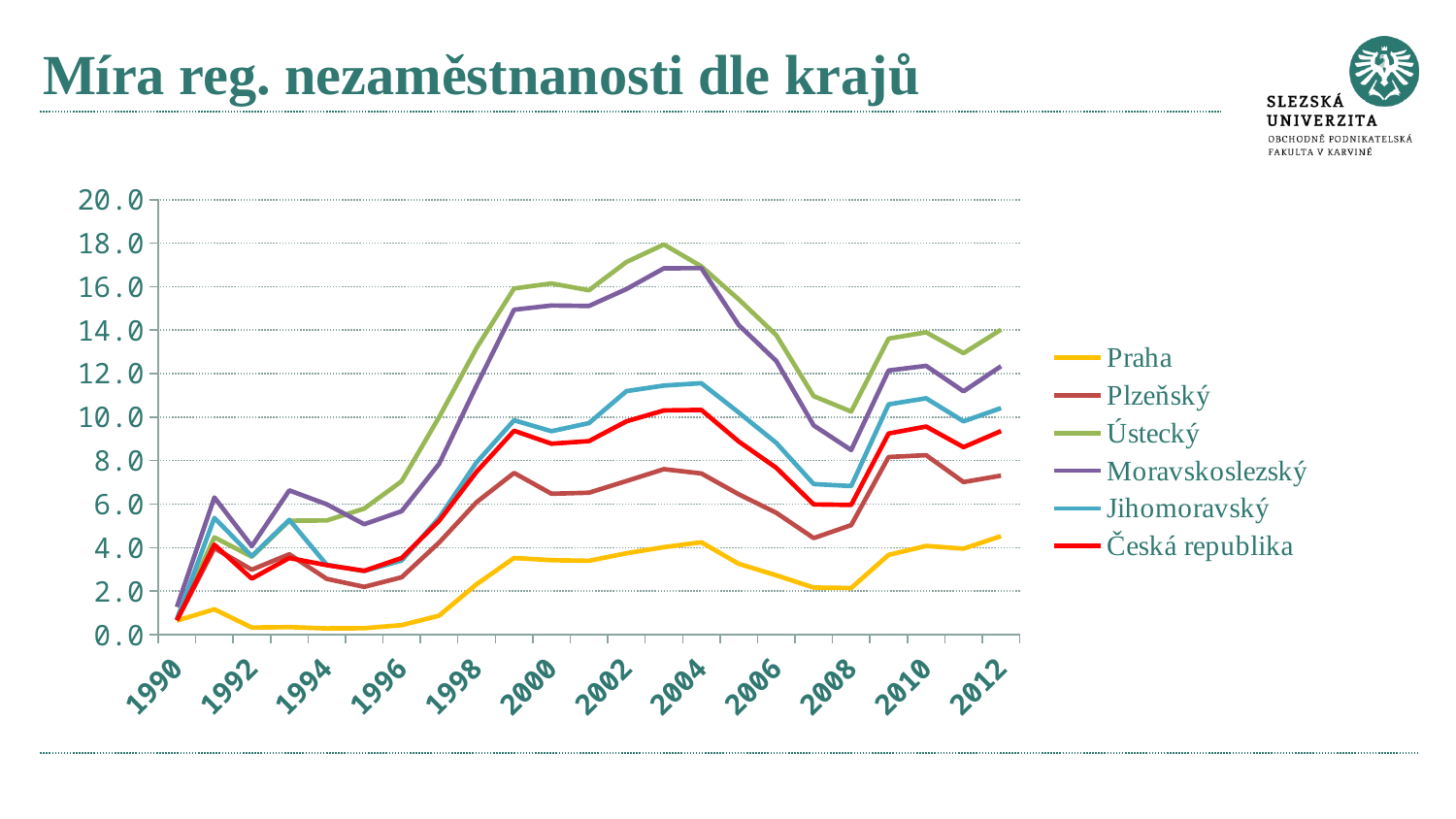
Which series has the highest value in 2003? Ústecký Does the Ústecký line rise or fall between 2004 and 2008? fall Which series has the lowest value in 2012? Praha How many series does the legend list? 6 Which is larger in 2010, the value for Moravskoslezský or the value for Jihomoravský? Moravskoslezský What kind of chart is shown on the slide? line chart Which is larger in 2000, the value for Plzeňský or the value for Praha? Plzeňský What is the title of the chart on the slide? Míra reg. nezaměstnanosti dle krajů Which series is drawn in red? Česká republika Is the value for Praha in 2012 greater or less than 6.0? less Is the value for Moravskoslezský in 2010 greater or less than 10.0? greater Is the value for Ústecký in 2003 greater or less than 16.0? greater